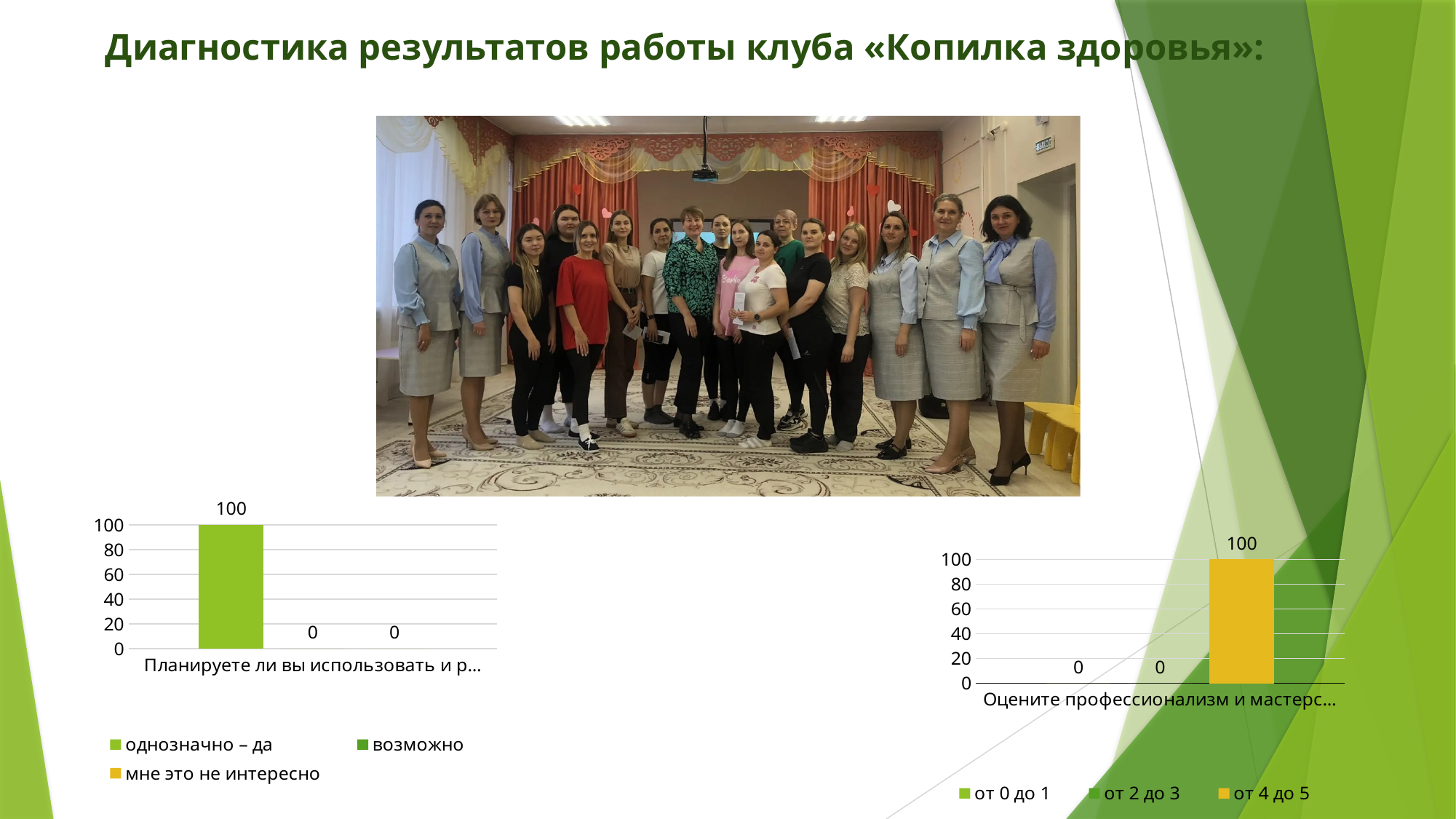
In the left chart, what is the difference between the values for "однозначно – да" and "возможно"? 100 In the right chart, what is the value for the series "от 0 до 1"? 0 What kind of chart is the right chart? bar chart In the right chart, what colour is the bar for "от 4 до 5"? yellow In the right chart, what is the value for the series "от 4 до 5"? 100 In the left chart, what is the value for the series "однозначно – да"? 100 In the right chart, which series has the highest value? от 4 до 5 In the left chart, what is the value for the series "мне это не интересно"? 0 In the right chart, how many series does the legend list? 3 In the left chart, how many series does the legend list? 3 In the left chart, which series has the highest value? однозначно – да In the left chart, what is the value for the series "возможно"? 0